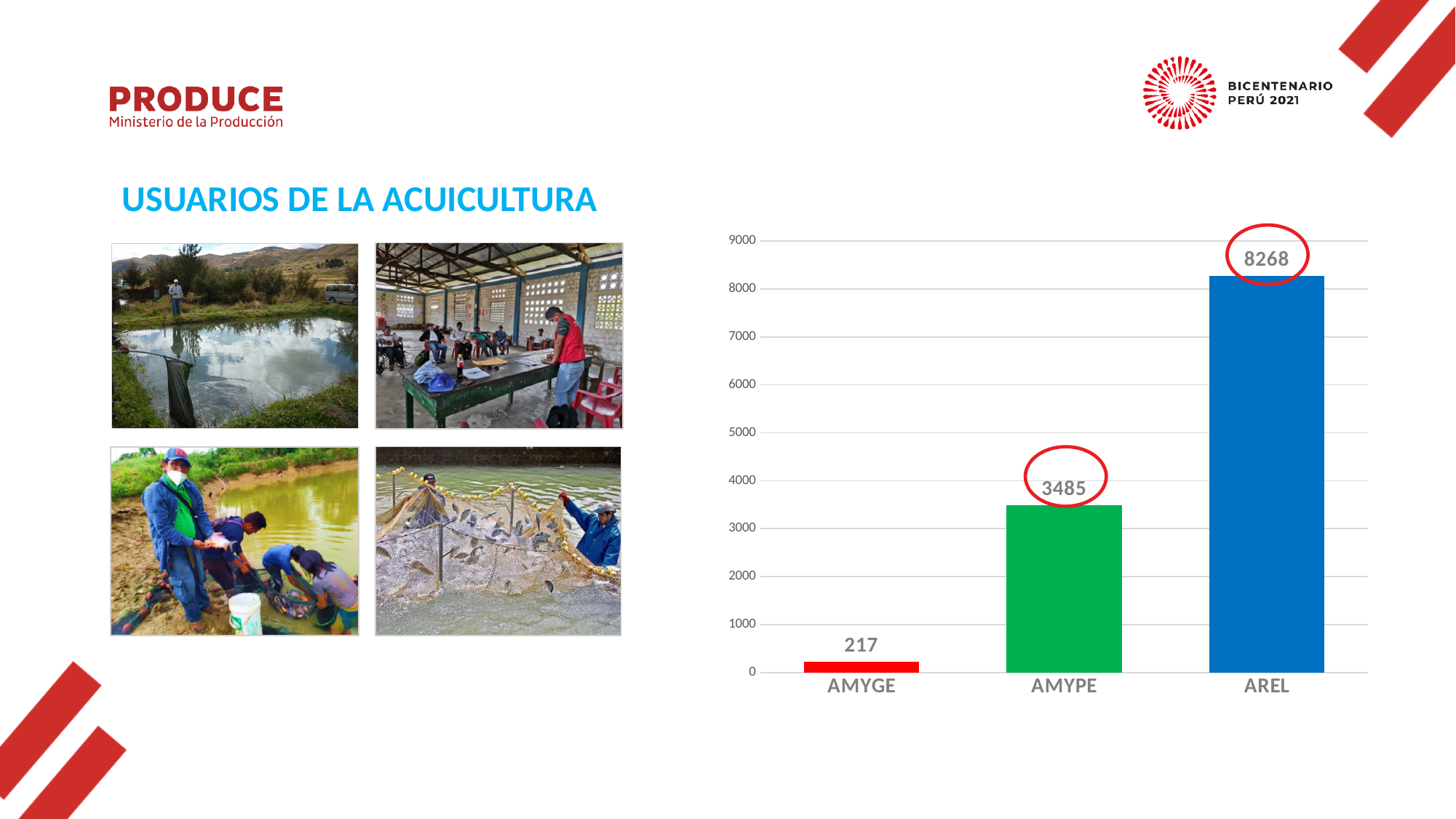
Is the value for AMYPE greater or less than 3000? greater What kind of chart is shown on the slide? bar chart Which category has the highest value? AREL What is the value for AMYPE? 3485 How many categories are shown on the x axis? 3 What is the value for AREL? 8268 Which category has the lowest value? AMYGE What is the difference between the values for AMYPE and AMYGE? 3268 What is the value for AMYGE? 217 What is the difference between the values for AREL and AMYPE? 4783 What colour is the bar for AREL? blue Which is larger, the value for AMYPE or the value for AREL? AREL